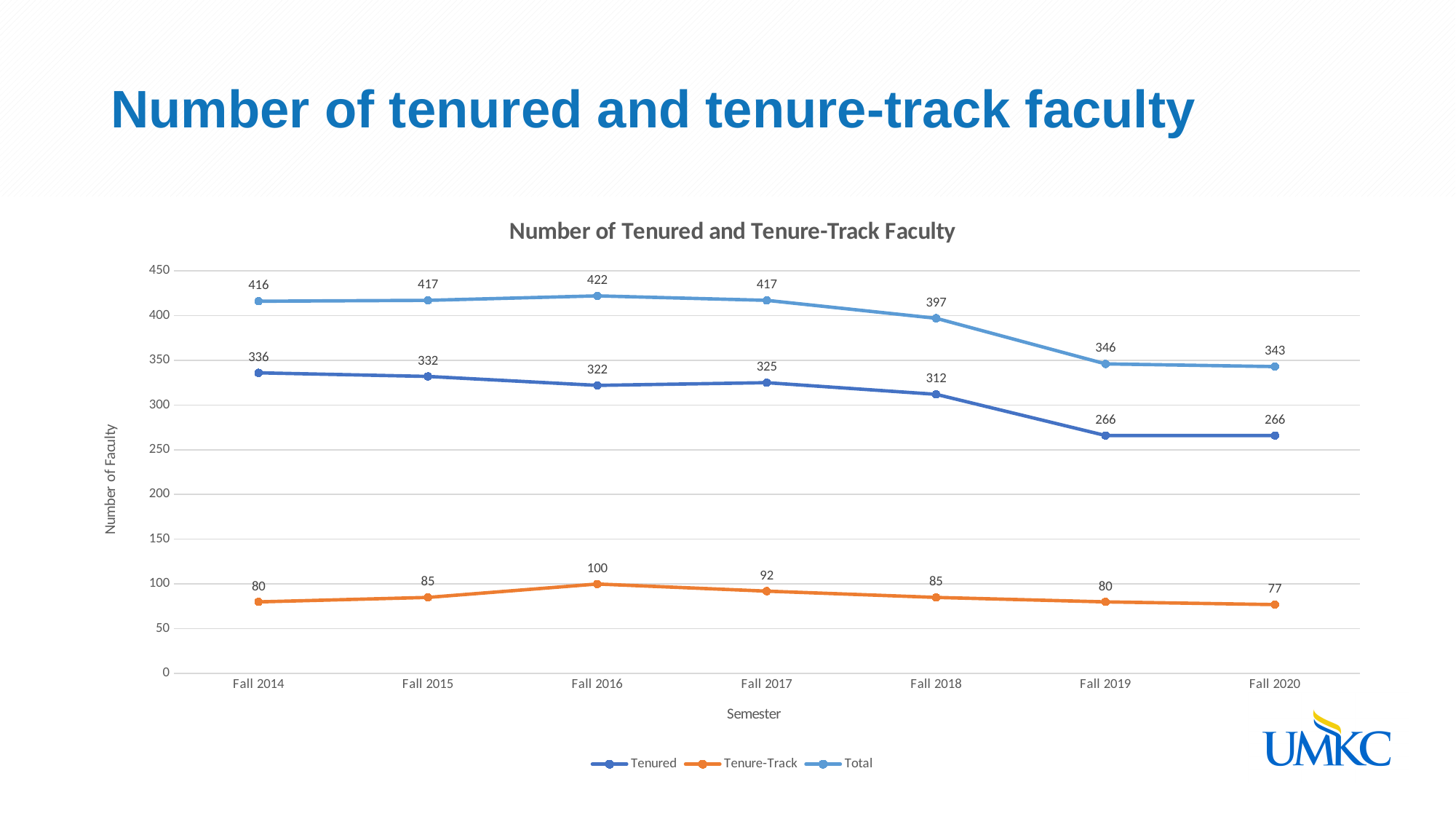
What kind of chart is shown on the slide? line chart How many series does the legend list? 3 Which is larger, the Total for Fall 2018 or the Total for Fall 2019? Fall 2018 How many semesters are shown on the x axis? 7 In which semester is the Tenure-Track series highest? Fall 2016 What is the difference between the Tenured values for Fall 2014 and Fall 2020? 70 What is the Total number of faculty in Fall 2016? 422 Is the Tenured value for Fall 2019 greater or less than 300? less In which semester is the Total series lowest? Fall 2020 What is the Tenured value for Fall 2018? 312 Does the Total series rise or fall from Fall 2017 to Fall 2020? fall What is the Tenure-Track value for Fall 2020? 77